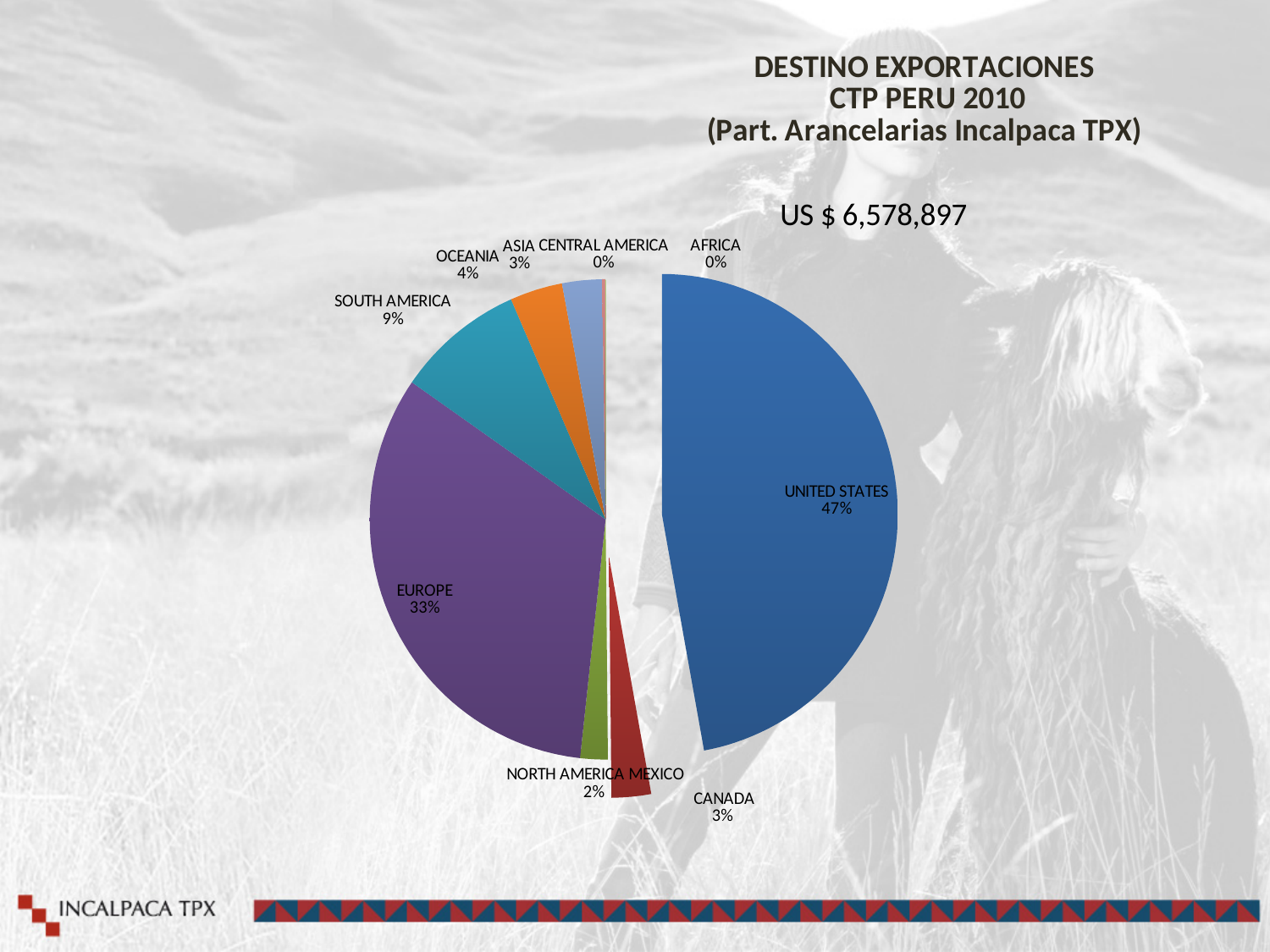
How many destination categories are shown in the pie chart? 9 What share of exports goes to Oceania? 4% What is the difference in percentage points between the United States share and the Europe share? 14 percentage points What share of exports goes to the United States? 47% What share of exports goes to Europe? 33% Which destination has the largest share of exports? UNITED STATES What share of exports goes to North America Mexico? 2% What kind of chart is shown on the slide? pie chart What share of exports goes to Canada? 3% Which is larger, the share for Europe or the share for South America? Europe What total export value is shown above the pie chart? US $ 6,578,897 What share of exports goes to South America? 9%